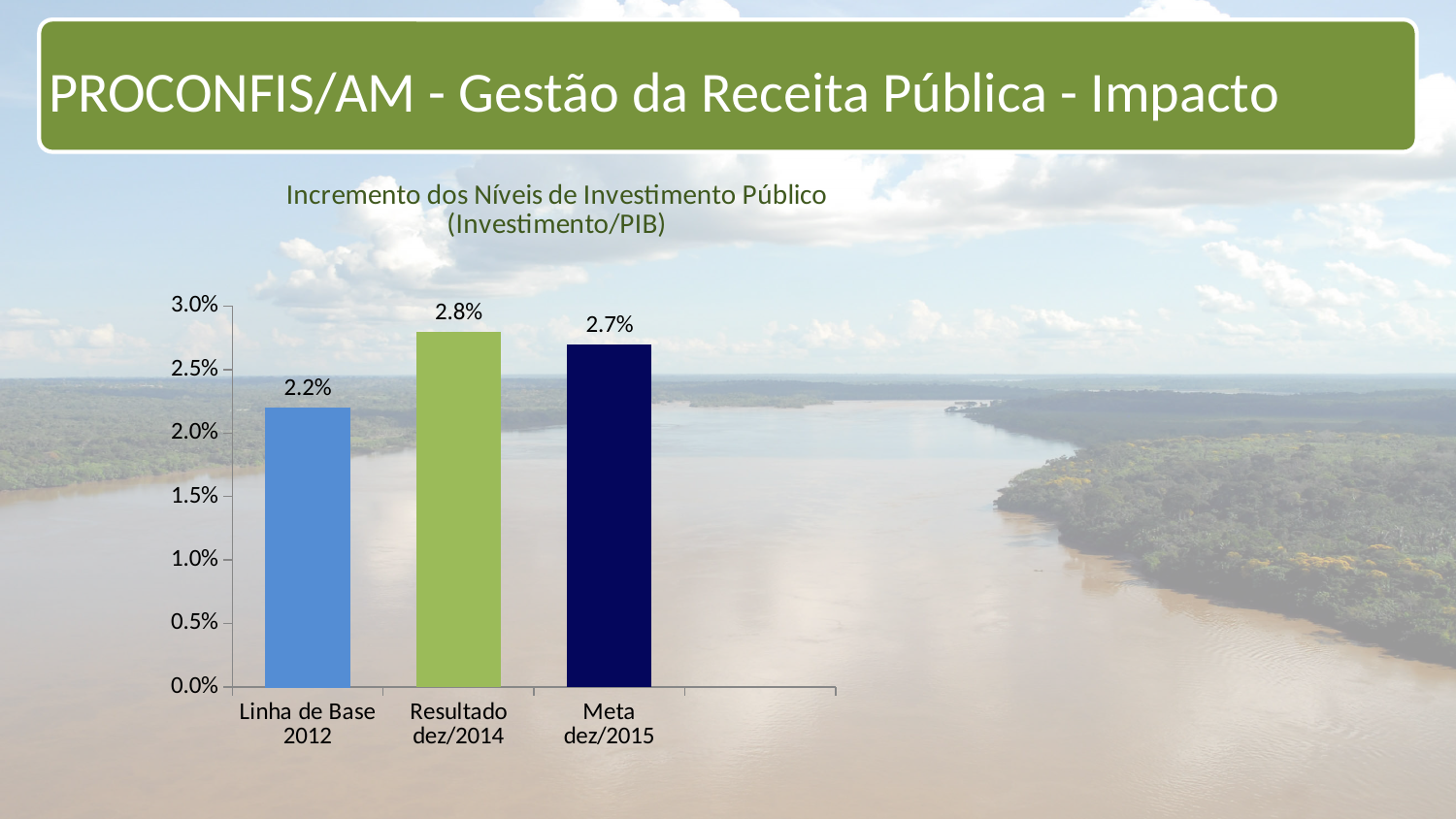
What is the difference between Resultado dez/2014 and Meta dez/2015? 0.1% What kind of chart is shown on the slide? bar chart What is the difference between Resultado dez/2014 and Linha de Base 2012? 0.6% What is the value for Resultado dez/2014? 2.8% What is the value for Meta dez/2015? 2.7% Which category has the lowest value? Linha de Base 2012 What is the title of the chart? Incremento dos Níveis de Investimento Público (Investimento/PIB) Is the value for Linha de Base 2012 greater or less than 2.5%? less Which category has the highest value? Resultado dez/2014 What is the value for Linha de Base 2012? 2.2% Which is larger, Meta dez/2015 or Linha de Base 2012? Meta dez/2015 How many categories are shown in the chart? 3